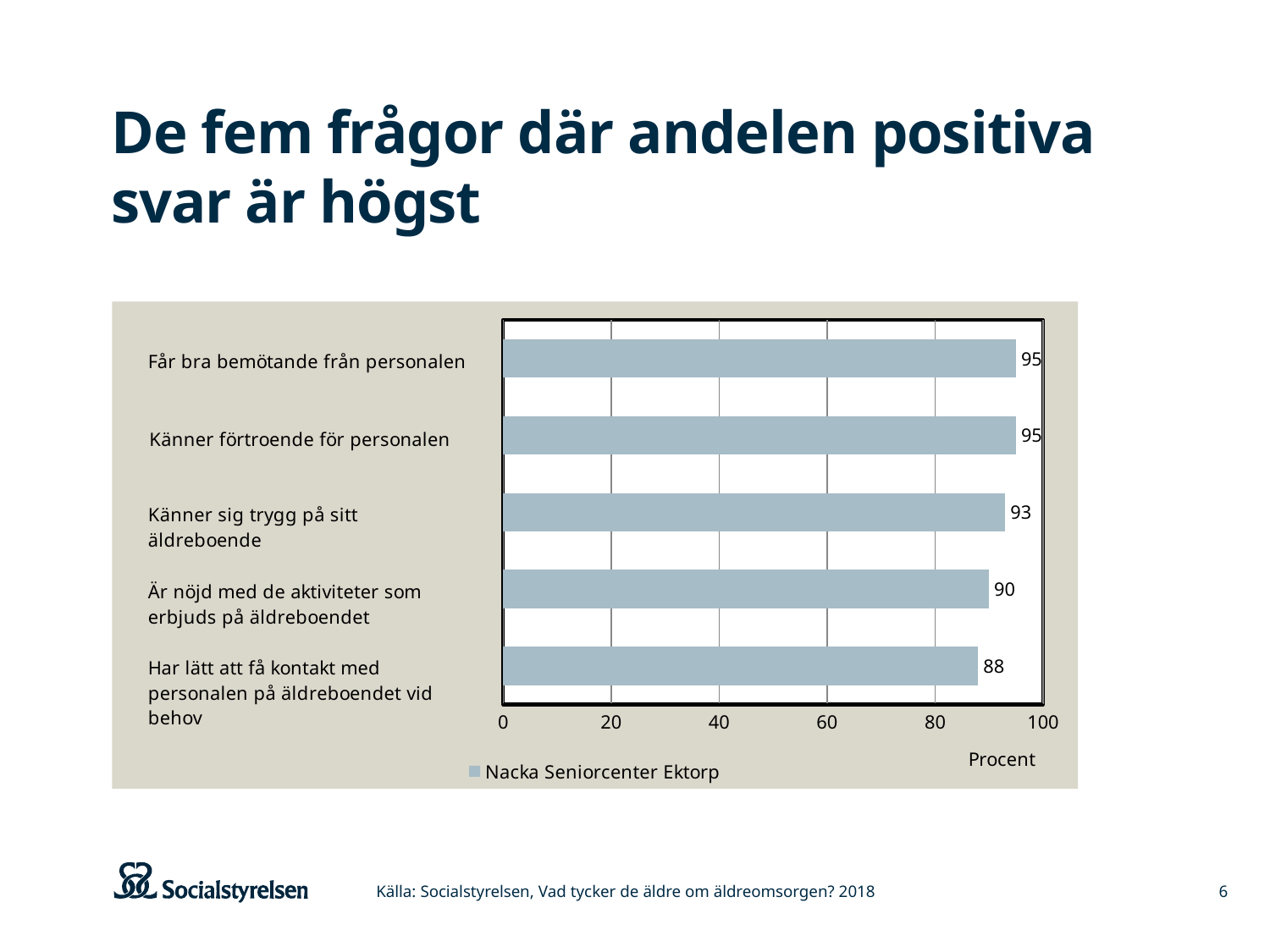
What is the value for "Är nöjd med de aktiviteter som erbjuds på äldreboendet"? 90 What is the name of the series shown in the legend? Nacka Seniorcenter Ektorp Which is larger: the value for "Känner sig trygg på sitt äldreboende" or the value for "Har lätt att få kontakt med personalen på äldreboendet vid behov"? Känner sig trygg på sitt äldreboende What is the difference between the values for "Får bra bemötande från personalen" and "Har lätt att få kontakt med personalen på äldreboendet vid behov"? 7 Which category has the lowest value? Har lätt att få kontakt med personalen på äldreboendet vid behov What is the difference between the values for "Känner sig trygg på sitt äldreboende" and "Är nöjd med de aktiviteter som erbjuds på äldreboendet"? 3 What kind of chart is shown on the slide? Bar chart What is the value for "Känner sig trygg på sitt äldreboende"? 93 How many series does the legend list? 1 What is the value for "Känner förtroende för personalen"? 95 What is the value for "Har lätt att få kontakt med personalen på äldreboendet vid behov"? 88 How many categories are shown in the chart? 5